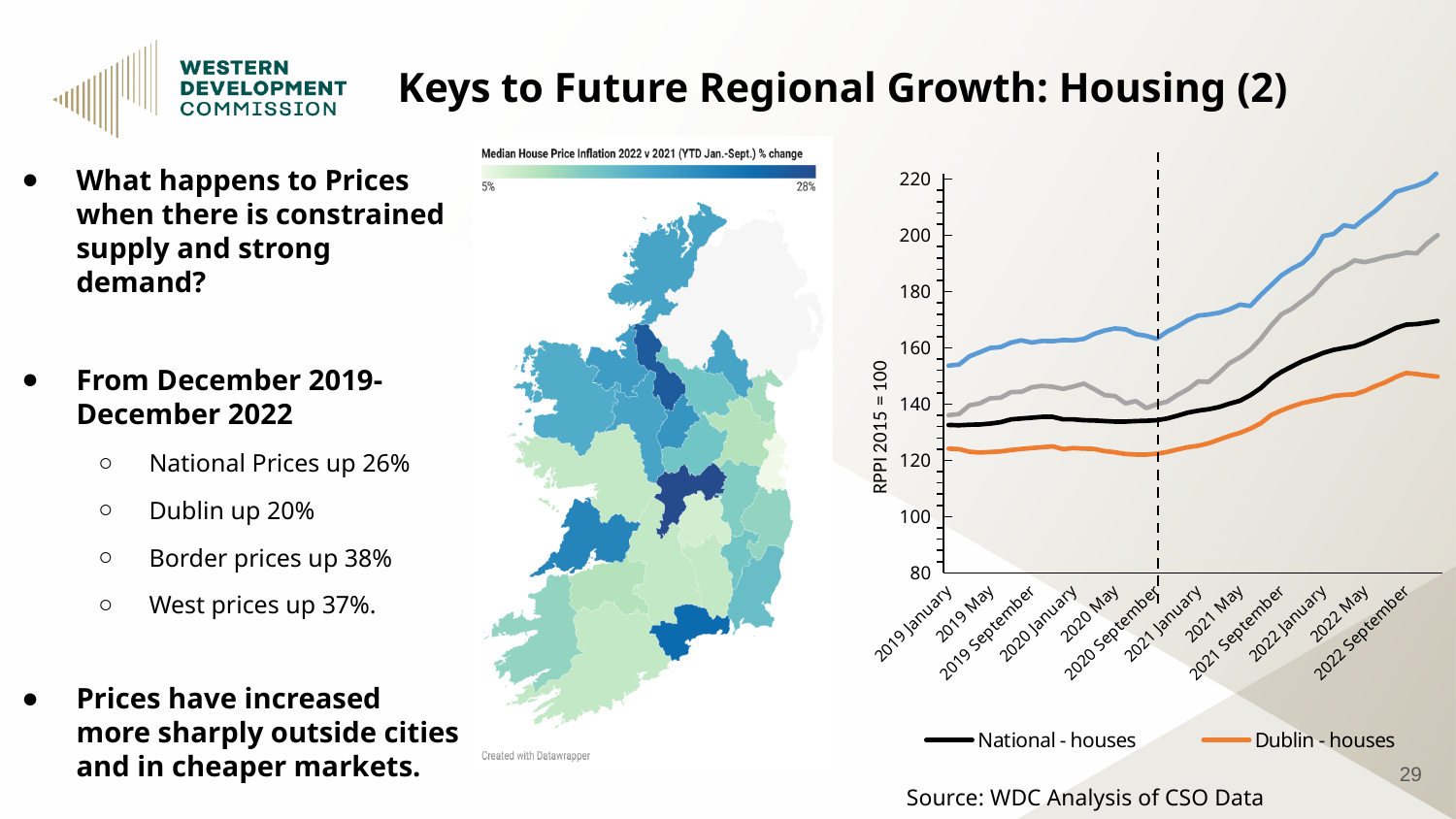
In the line chart on the right, is the value for Dublin - houses in 2022 September greater or less than 140? greater What is the label on the vertical axis of the line chart on the right? RPPI 2015 = 100 In the line chart on the right, how many series does the legend list? 2 In the line chart on the right, which series is higher in 2022 September, National - houses or Dublin - houses? National - houses In the line chart on the right, which two series are named in the legend? National - houses and Dublin - houses In the line chart on the right, how many date labels are shown along the x axis? 12 In the line chart on the right, is the value for National - houses in 2022 September greater or less than 160? greater In the line chart on the right, is the value for Dublin - houses in 2020 September greater or less than 140? less In the line chart on the right, does the National - houses series rise or fall from 2019 January to 2022 September? rise What kind of chart is the chart on the right of the slide (with the RPPI axis)? line chart